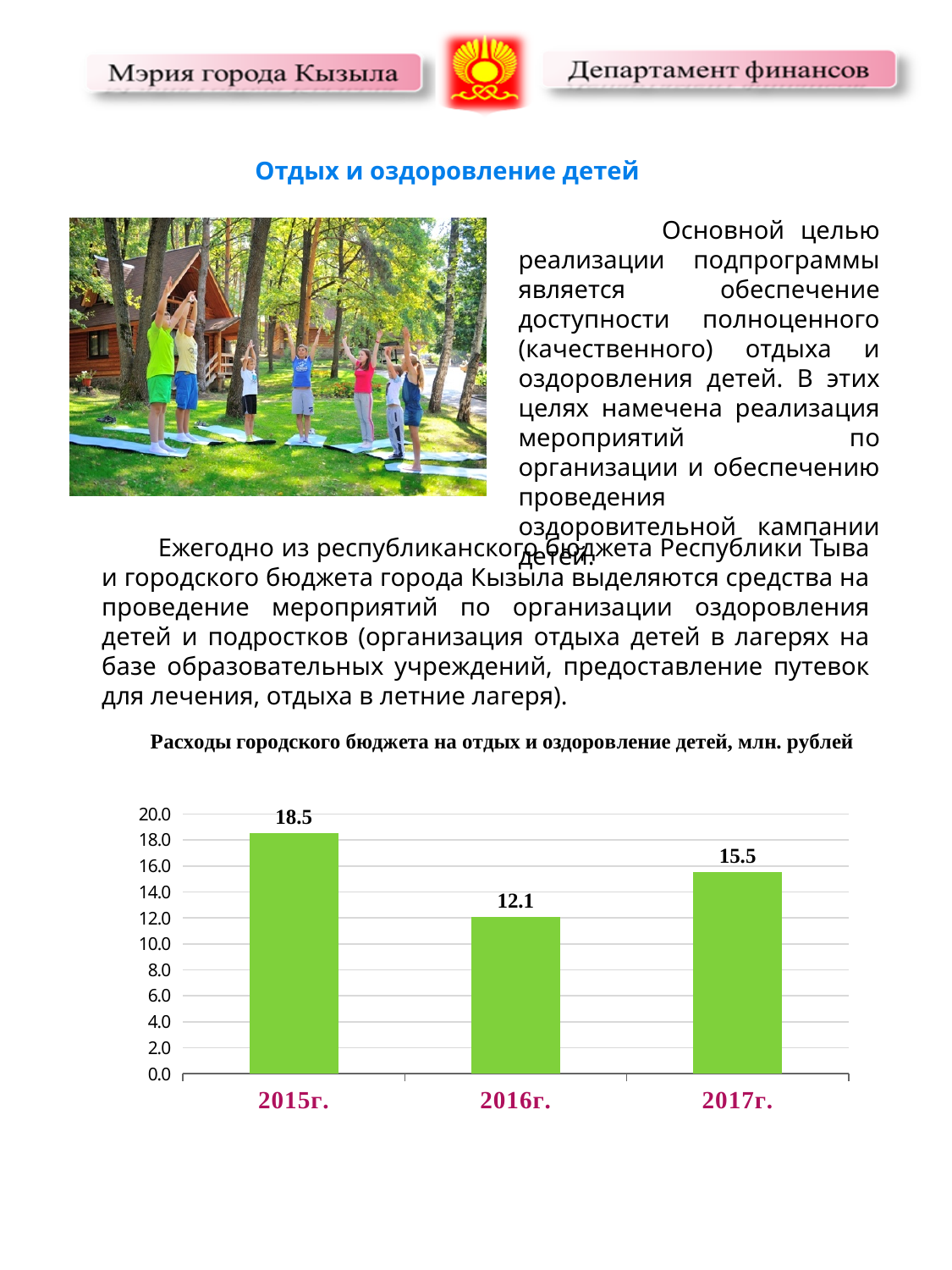
How many years are shown on the chart? 3 What is the value for 2017г.? 15.5 What is the title of the chart? Расходы городского бюджета на отдых и оздоровление детей, млн. рублей What is the value for 2016г.? 12.1 What is the difference between the values for 2017г. and 2016г.? 3.4 Which is larger, the value for 2015г. or the value for 2017г.? 2015г. Which year has the lowest value? 2016г. What is the value for 2015г.? 18.5 What kind of chart is shown on the slide? bar chart What is the difference between the values for 2015г. and 2016г.? 6.4 Is the value for 2016г. greater or less than 14.0? less Which year has the highest value? 2015г.